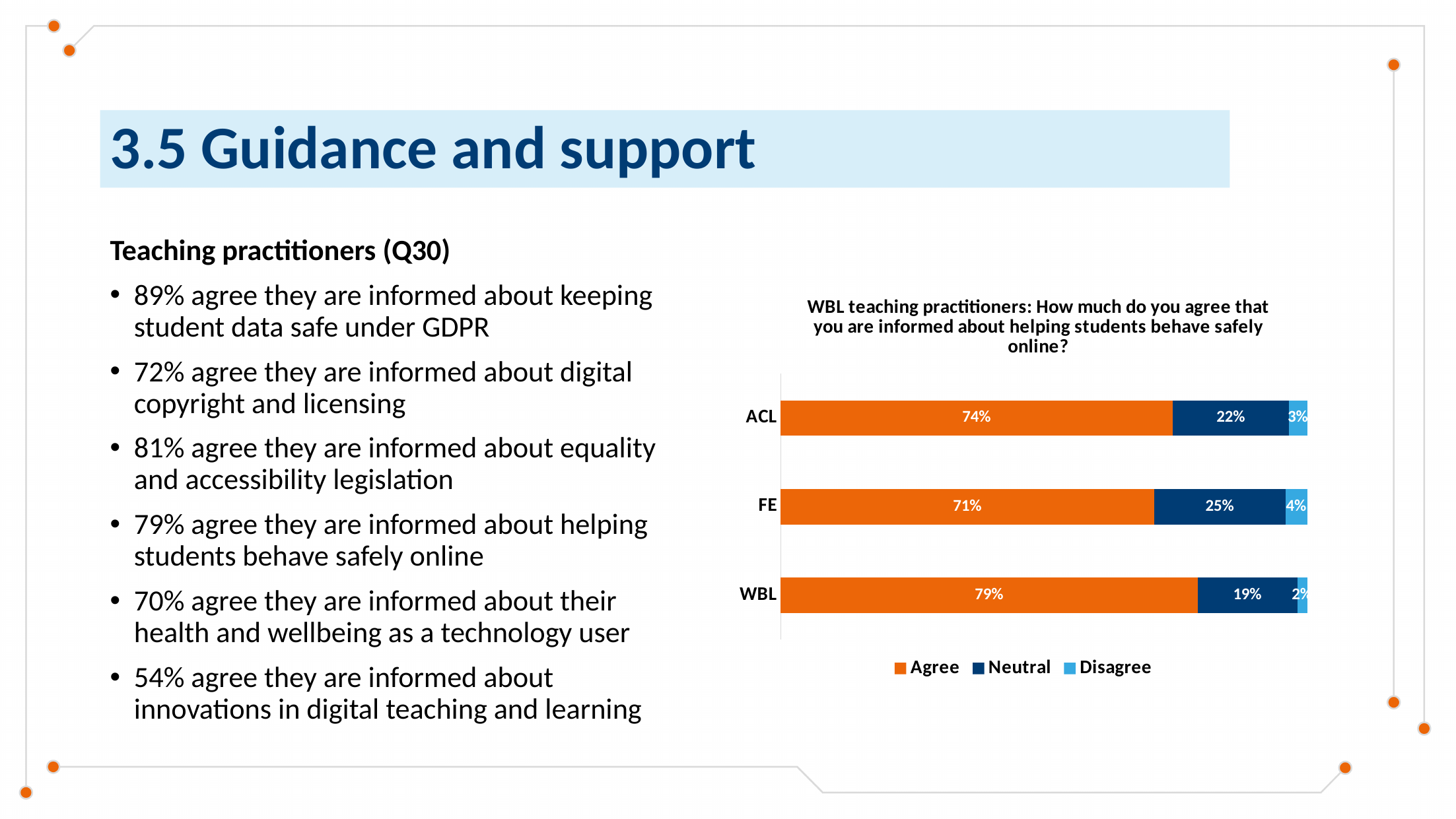
Which colour represents the Agree series in the chart? Orange What is the Disagree value for ACL in the chart? 3% What percentage of WBL teaching practitioners agree that they are informed about helping students behave safely online? 79% What is the Neutral value for FE in the chart? 25% What kind of chart is shown on the slide? Stacked bar chart How many series does the chart legend list? 3 Which category has the lowest Agree percentage in the chart? FE What is the total of the ACL bar (Agree + Neutral + Disagree)? 99% How many categories are shown on the chart's vertical axis? 3 Which category has the highest Agree percentage in the chart? WBL What is the difference between the Agree percentages for WBL and FE? 8% Which is larger, the Neutral value for ACL or the Neutral value for WBL? ACL